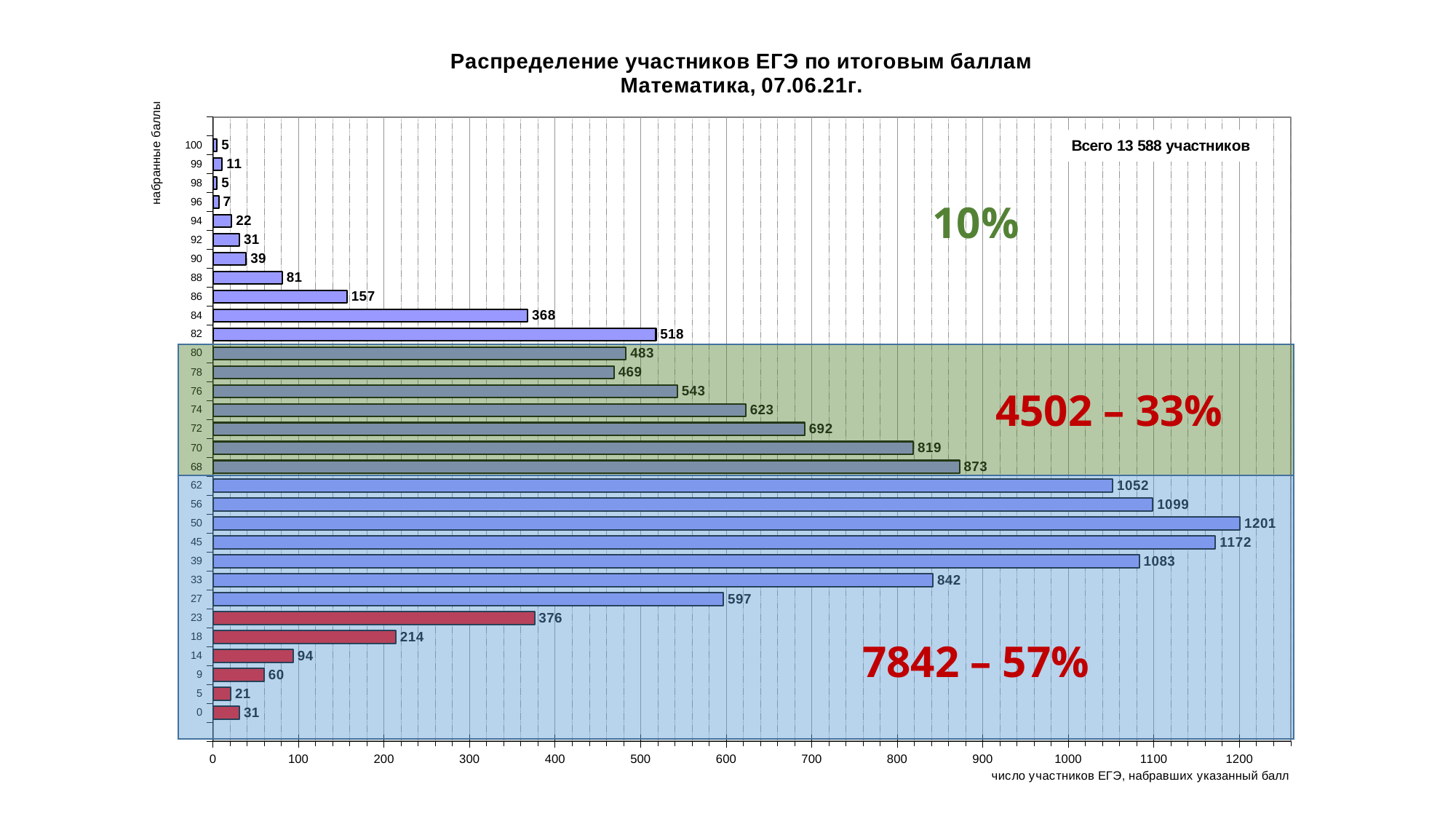
How many participants scored 82 points? 518 How many participants scored 0 points? 31 Which score has the highest number of participants? 50 What is the difference between the number of participants scoring 45 and those scoring 39? 89 How many participants scored 68 points? 873 What total number of participants is stated on the chart? 13 588 Which score has more participants, 23 or 27? 27 What kind of chart is shown on the slide? bar chart How many participants scored 50 points? 1201 What is the difference between the number of participants scoring 84 and those scoring 86? 211 Which score has more participants, 72 or 76? 72 How many score categories are shown on the chart? 31